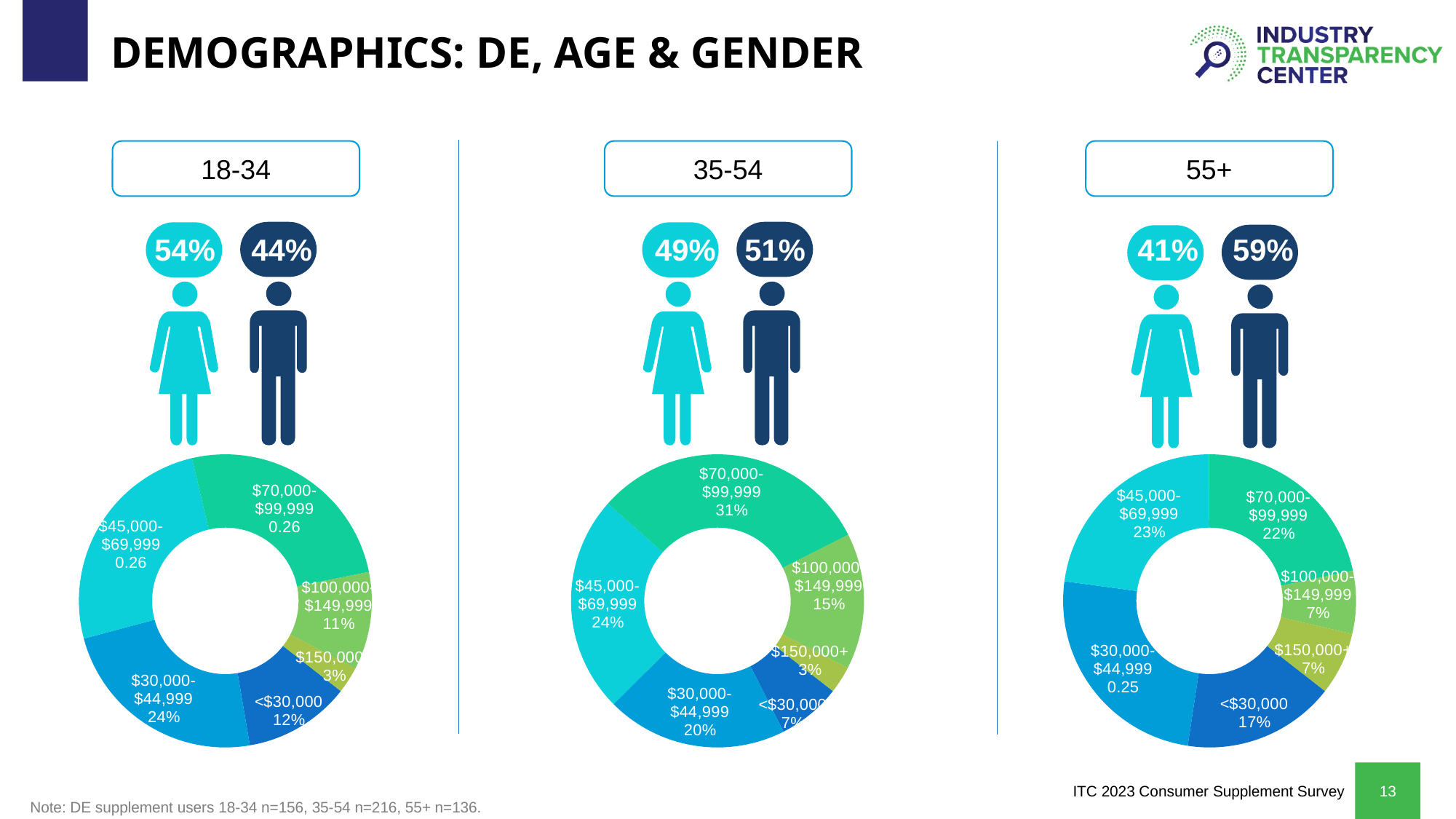
In the 55+ donut chart, what is the difference between the $45,000-$69,999 share and the <$30,000 share? 6 percentage points What type of chart is used to show the income distribution for each age group? Donut (pie) chart In the 18-34 donut chart, which income bracket has the smallest share? $150,000+ In the 35-54 donut chart, what is the difference between the $45,000-$69,999 share and the $30,000-$44,999 share? 4 percentage points In the 35-54 donut chart, which income bracket has the largest share? $70,000-$99,999 How many income brackets are shown in the 55+ donut chart? 6 In the 35-54 donut chart, which is larger: the $100,000-$149,999 share or the <$30,000 share? $100,000-$149,999 In the 35-54 donut chart, which income bracket has the smallest share? $150,000+ In the 18-34 donut chart, what value is printed for the $30,000-$44,999 bracket? 24% In the 55+ donut chart, what share is shown for the <$30,000 income bracket? 17% In the 35-54 donut chart, what share is shown for the $70,000-$99,999 income bracket? 31% In the 18-34 donut chart, what value is printed for the $100,000-$149,999 bracket? 11%